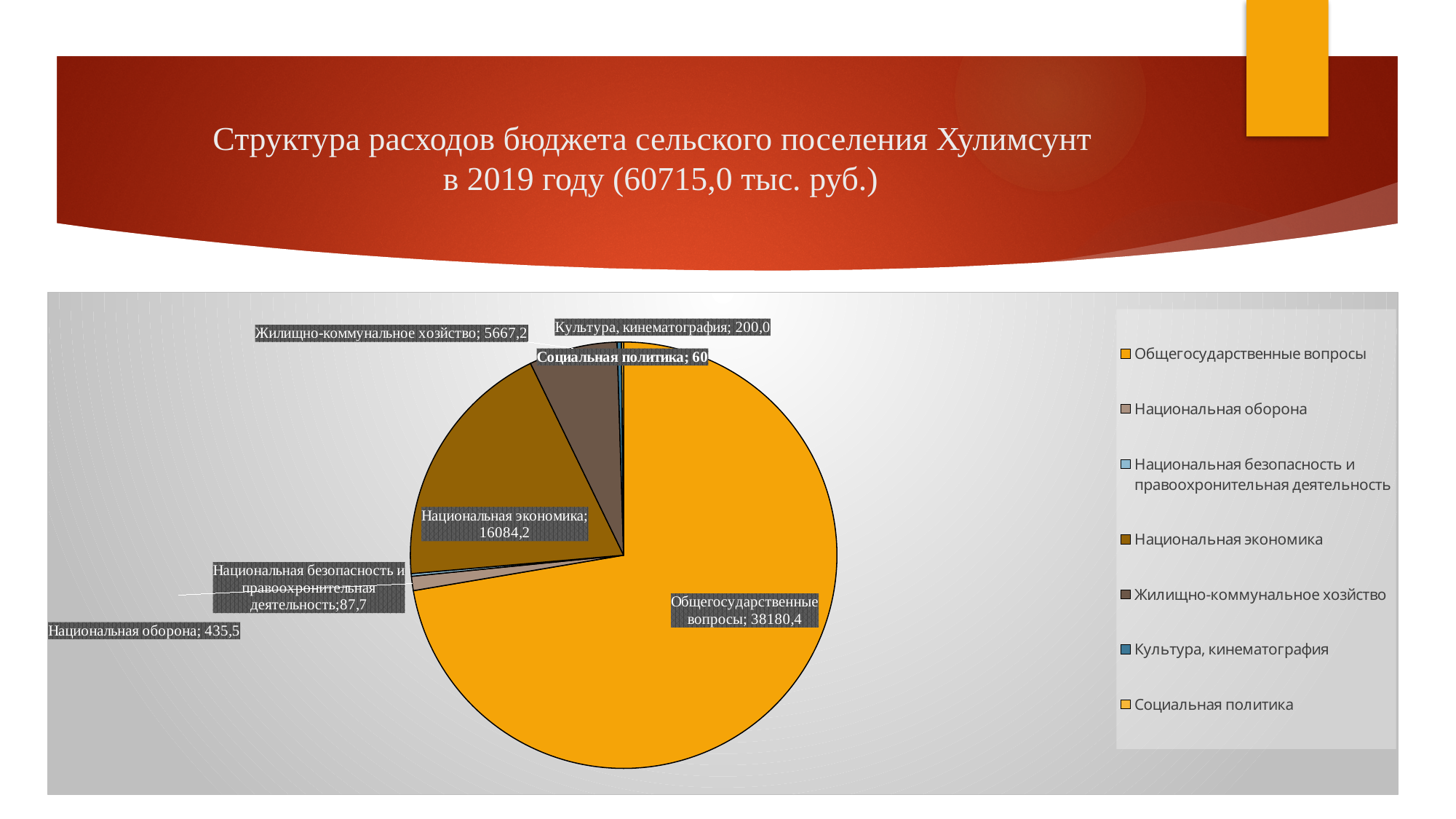
What total amount is stated in the slide title? 60715,0 тыс. руб. What is the value for Социальная политика? 60 What kind of chart is shown on the slide? pie chart Which is larger: Национальная оборона or Культура, кинематография? Национальная оборона What is the value for Национальная оборона? 435,5 What is the value for Национальная экономика? 16084,2 Which category has the smallest value? Социальная политика What is the value for Жилищно-коммунальное хозяйство? 5667,2 How many categories does the legend list? 7 What is the value for Общегосударственные вопросы? 38180,4 What is the difference between Общегосударственные вопросы and Национальная экономика? 22096,2 Which category has the largest slice of the pie? Общегосударственные вопросы